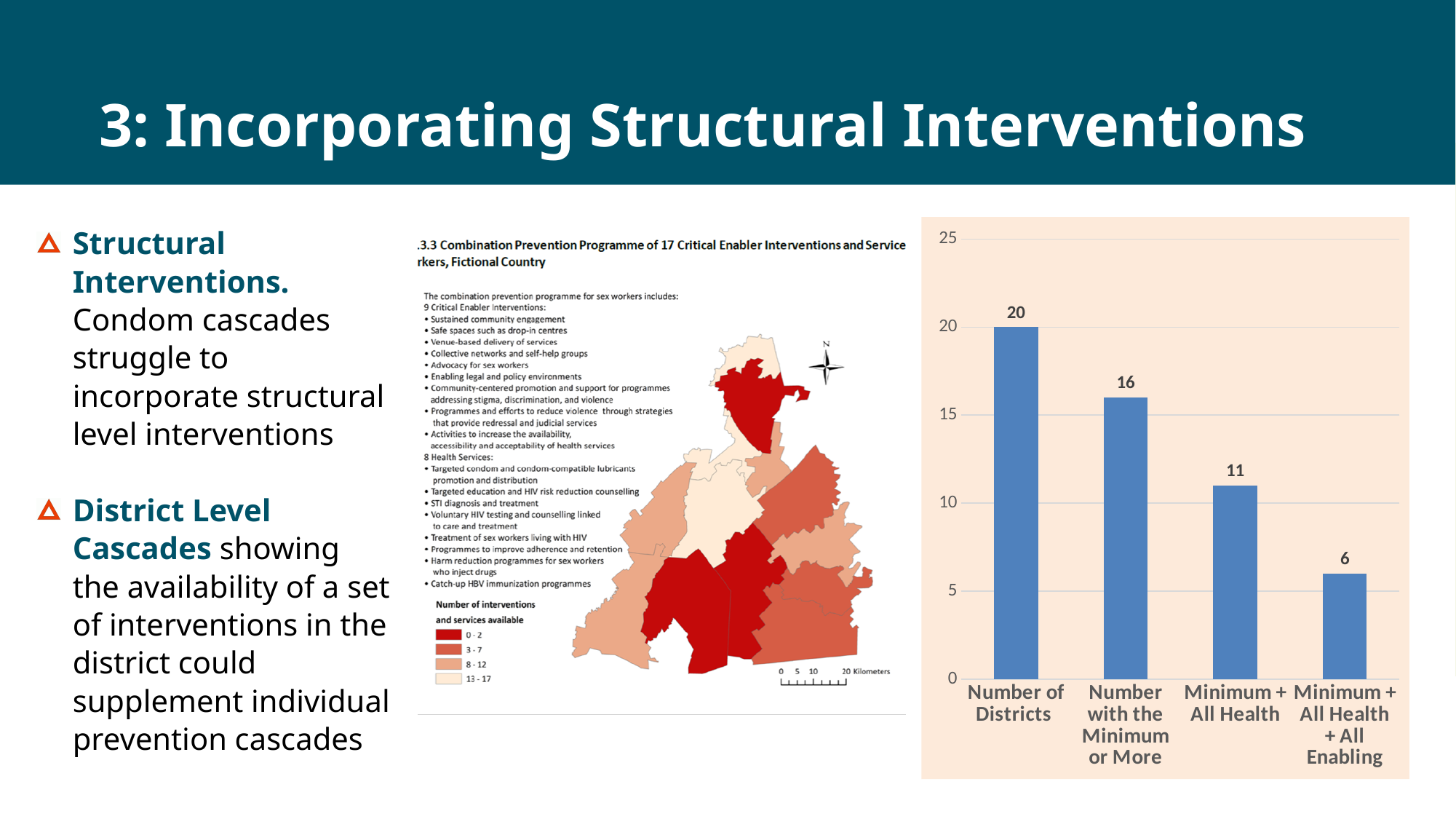
What is the value for Minimum + All Health + All Enabling? 6 Do the values rise or fall from left to right across the categories? fall What is the value for Number of Districts? 20 What is the difference between Number of Districts and Number with the Minimum or More? 4 What is the value for Number with the Minimum or More? 16 Which category has the highest value? Number of Districts What kind of chart is shown on the right of the slide? bar chart Which is larger, Number with the Minimum or More or Minimum + All Health? Number with the Minimum or More Which category has the lowest value? Minimum + All Health + All Enabling How many categories are shown on the bar chart? 4 What is the difference between Minimum + All Health and Minimum + All Health + All Enabling? 5 What is the value for Minimum + All Health? 11